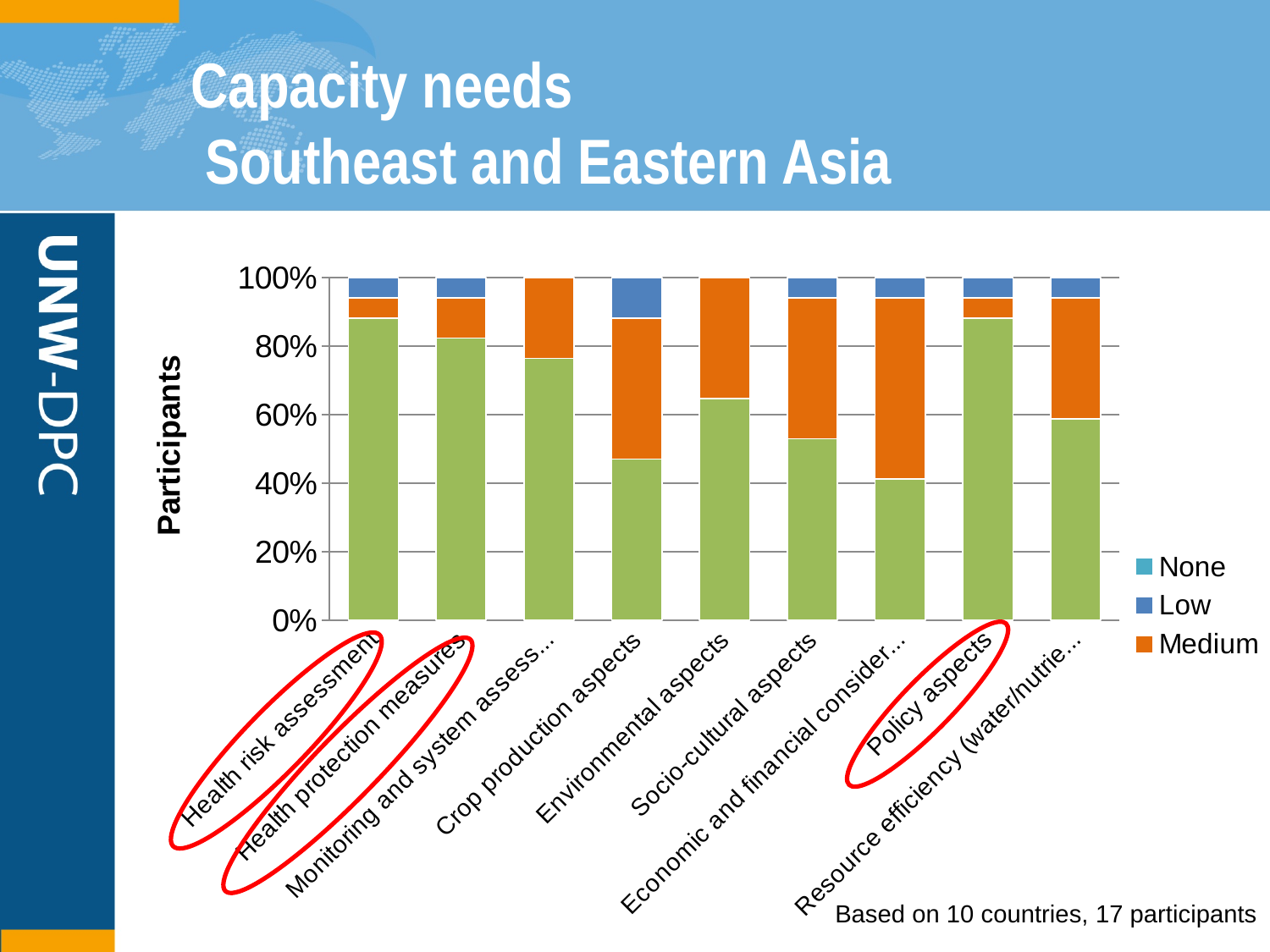
Is the green segment for Environmental aspects greater or less than 60%? greater How many categories are plotted along the x axis of the chart? 9 Is the green segment for Crop production aspects greater or less than 60%? less How many entries does the chart's legend list? 3 Which is larger, the green segment for Crop production aspects or the green segment for Economic and financial consider...? Crop production aspects Is the green segment for Health risk assessment greater or less than 80%? greater Which category has the largest Medium (orange) segment? Economic and financial consider... What kind of chart is shown on the slide? Stacked bar chart According to the note below the chart, how many countries and participants is the chart based on? 10 countries, 17 participants What is the label of the vertical axis of the chart? Participants